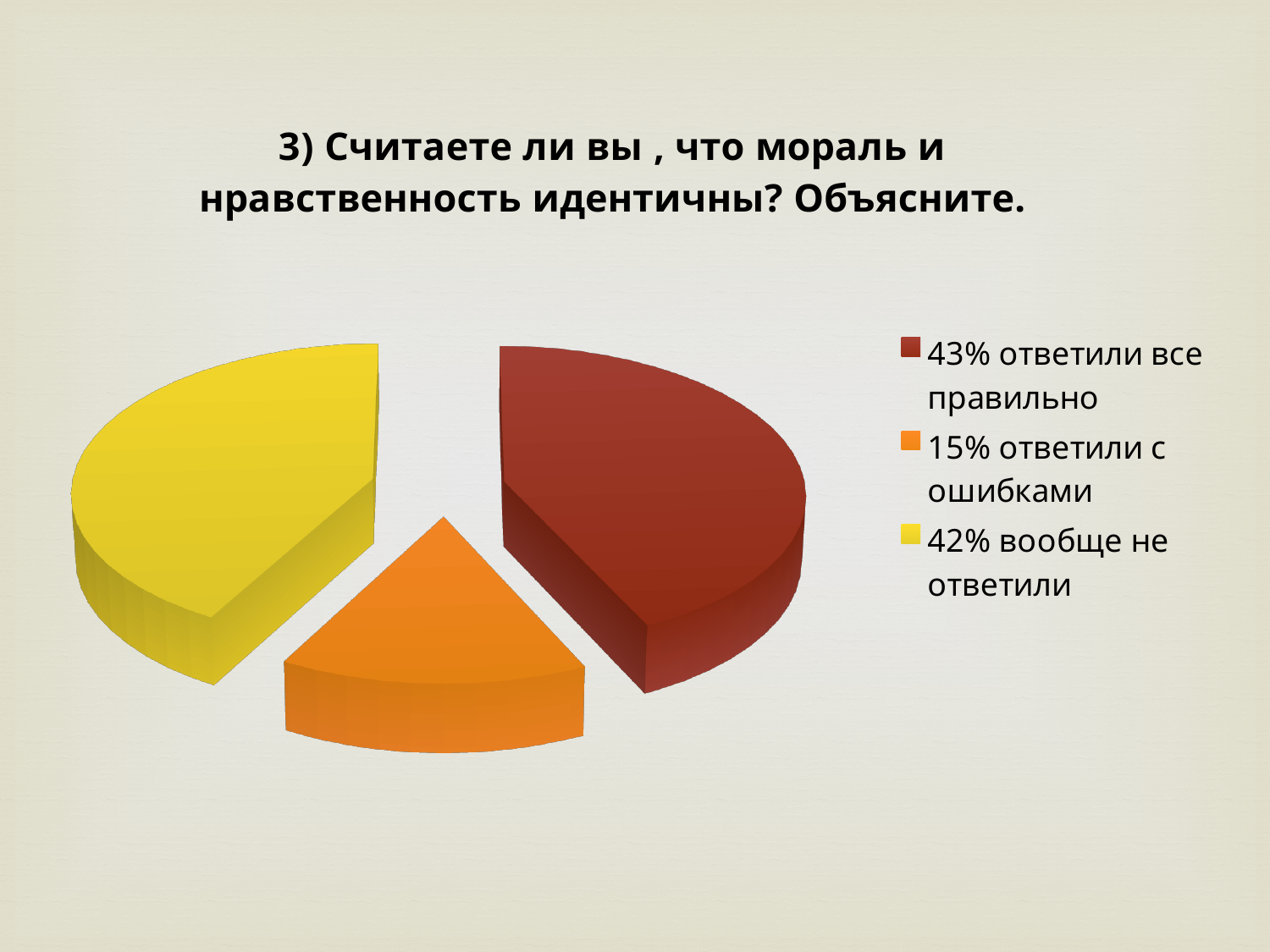
Which category has the largest share of the pie? ответили все правильно What kind of chart is shown on the slide? pie chart Which category has the smallest share of the pie? ответили с ошибками Which is larger: the share for "ответили все правильно" or the share for "вообще не ответили"? ответили все правильно How many entries does the legend list? 3 What share of respondents is shown for "ответили с ошибками"? 15% What is the difference in percentage points between "ответили все правильно" and "ответили с ошибками"? 28 What share of respondents is shown for "ответили все правильно"? 43% What is the difference in percentage points between "вообще не ответили" and "ответили с ошибками"? 27 How many slices does the pie chart have? 3 What share of respondents is shown for "вообще не ответили"? 42% What colour is the slice for "вообще не ответили"? yellow